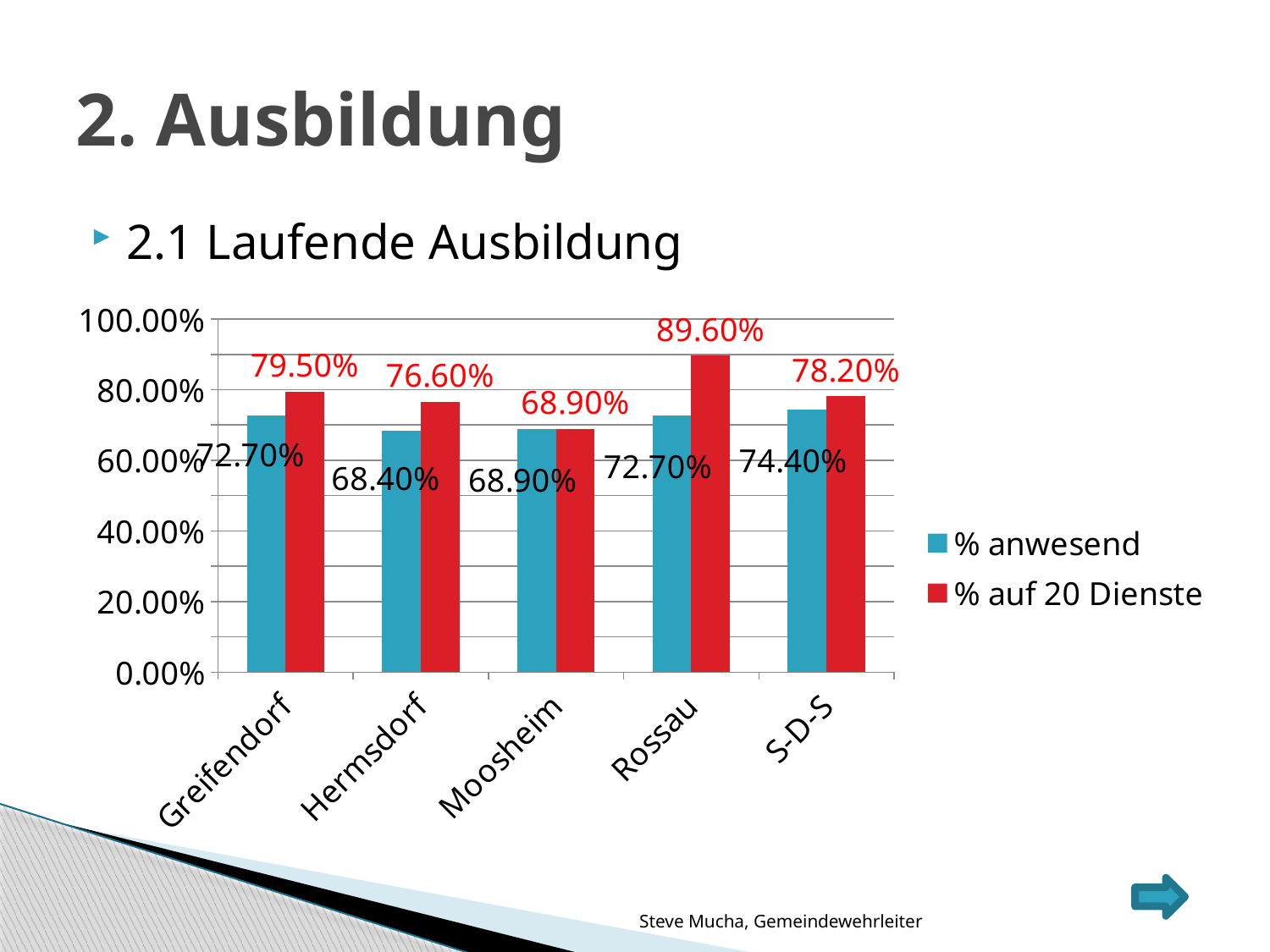
What is the "% anwesend" value for Greifendorf? 72.70% Is the "% auf 20 Dienste" value for Rossau greater or less than 80.00%? greater Which is larger for Greifendorf: "% anwesend" or "% auf 20 Dienste"? % auf 20 Dienste What is the difference between the "% auf 20 Dienste" and "% anwesend" values for Rossau? 16.90 percentage points What kind of chart is shown on the slide? Bar chart What is the "% anwesend" value for S-D-S? 74.40% What is the "% auf 20 Dienste" value for Hermsdorf? 76.60% How many categories are shown on the x axis? 5 How many series does the legend list? 2 What is the "% auf 20 Dienste" value for Rossau? 89.60% Which category has the highest "% auf 20 Dienste" value? Rossau Which category has the lowest "% anwesend" value? Hermsdorf